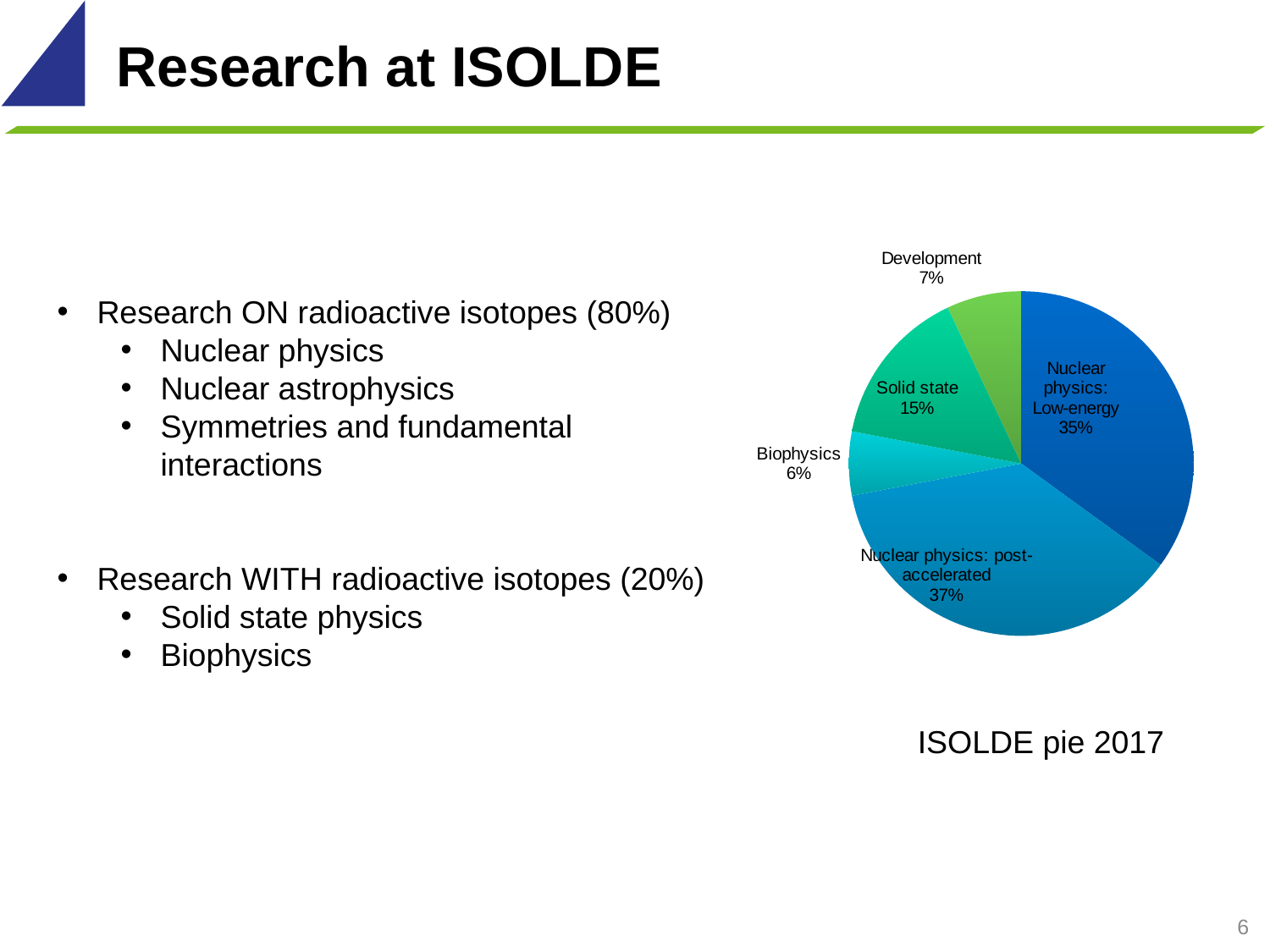
What share of the pie does Nuclear physics: Low-energy have? 35% What share of the pie does Development have? 7% Which slice of the pie is the largest? Nuclear physics: post-accelerated Which slice of the pie is the smallest? Biophysics What caption is shown below the pie chart? ISOLDE pie 2017 How many slices does the pie chart have? 5 What share of the pie does Nuclear physics: post-accelerated have? 37% What kind of chart is shown on the slide? pie chart What is the difference in percentage points between the Solid state slice and the Biophysics slice? 9 Which is larger, the Solid state slice or the Development slice? Solid state